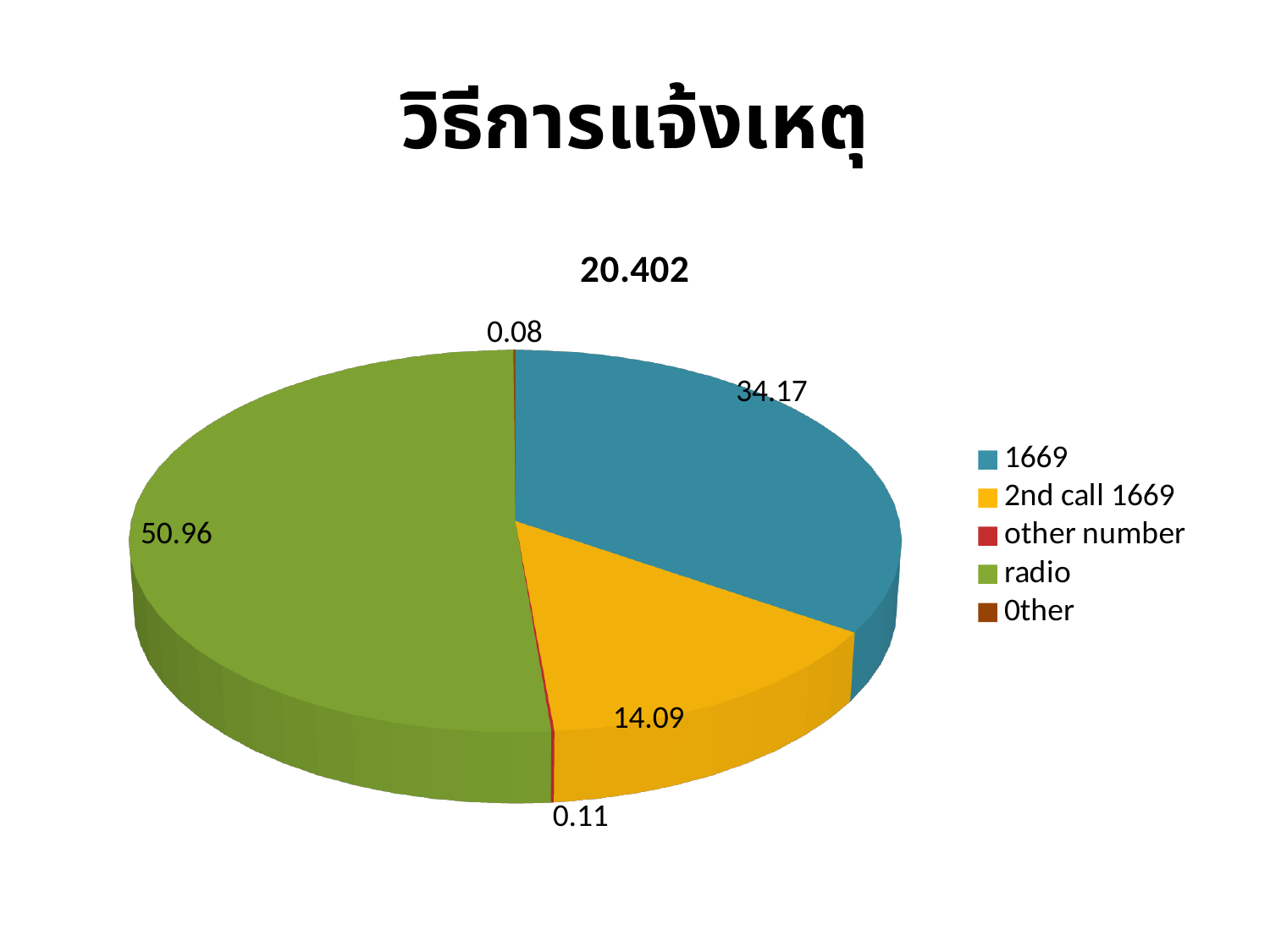
What is the value for 0ther? 0.08 How many categories does the legend list? 5 Which category has the largest slice of the pie? radio What is the title shown above the pie chart? 20.402 What is the value for radio? 50.96 What is the difference between the values for radio and 1669? 16.79 What is the value for 1669? 34.17 Which is larger, the value for 1669 or the value for 2nd call 1669? 1669 What kind of chart is shown on the slide? pie chart Which category has the smallest slice of the pie? 0ther What is the value for 2nd call 1669? 14.09 What is the value for other number? 0.11